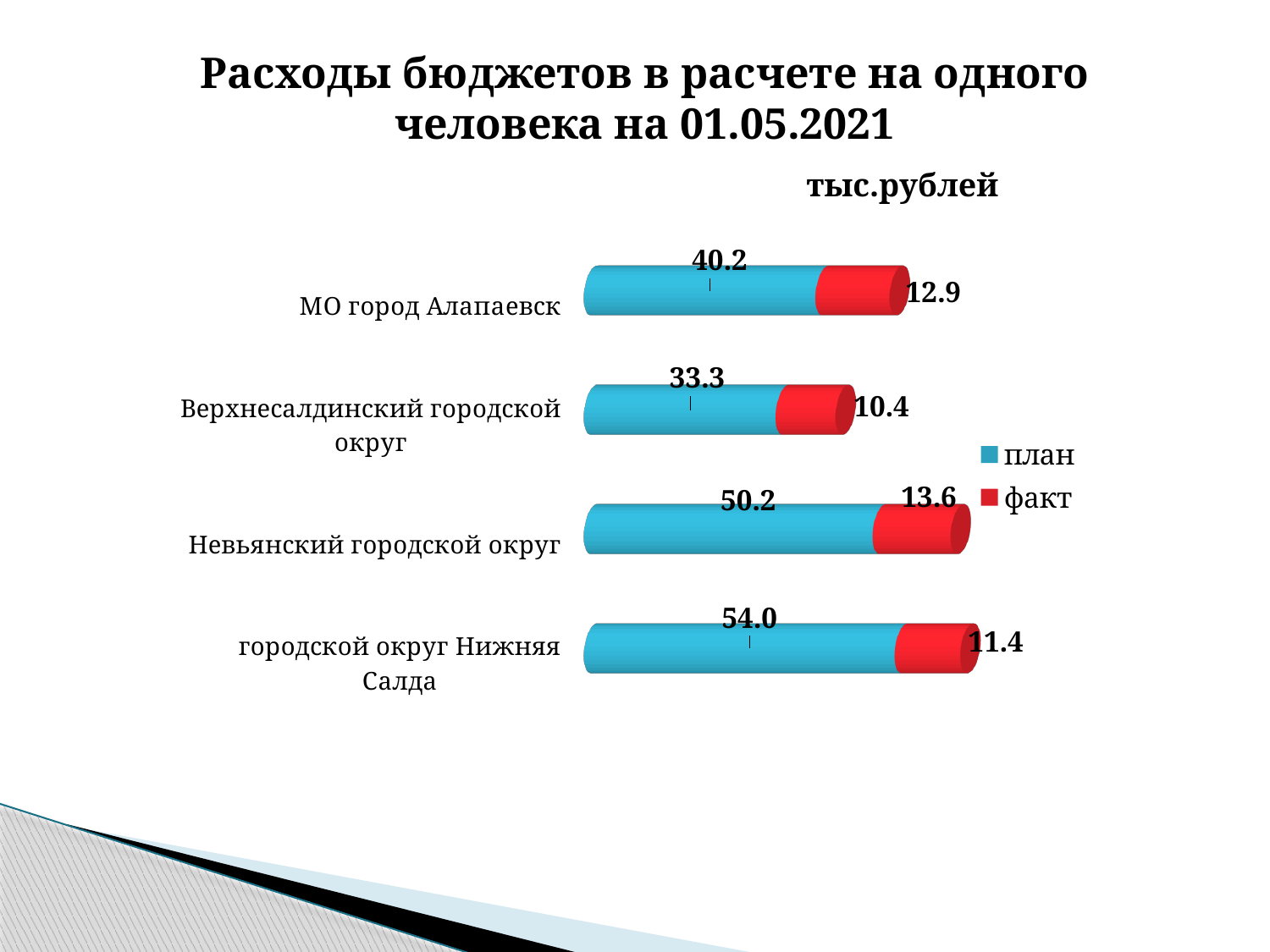
How many categories are shown in the chart? 4 What is the план value for городской округ Нижняя Салда? 54.0 Which category has the lowest факт value? Верхнесалдинский городской округ What is the план value for МО город Алапаевск? 40.2 How many series does the legend list? 2 Which category has the highest план value? городской округ Нижняя Салда What is the факт value for Невьянский городской округ? 13.6 What kind of chart is shown on the slide? Stacked bar chart What is the факт value for Верхнесалдинский городской округ? 10.4 Which is larger, the факт value for МО город Алапаевск or for городской округ Нижняя Салда? МО город Алапаевск What is the total of the stacked bar for Верхнесалдинский городской округ? 43.7 What is the difference between the план values for городской округ Нижняя Салда and Невьянский городской округ? 3.8